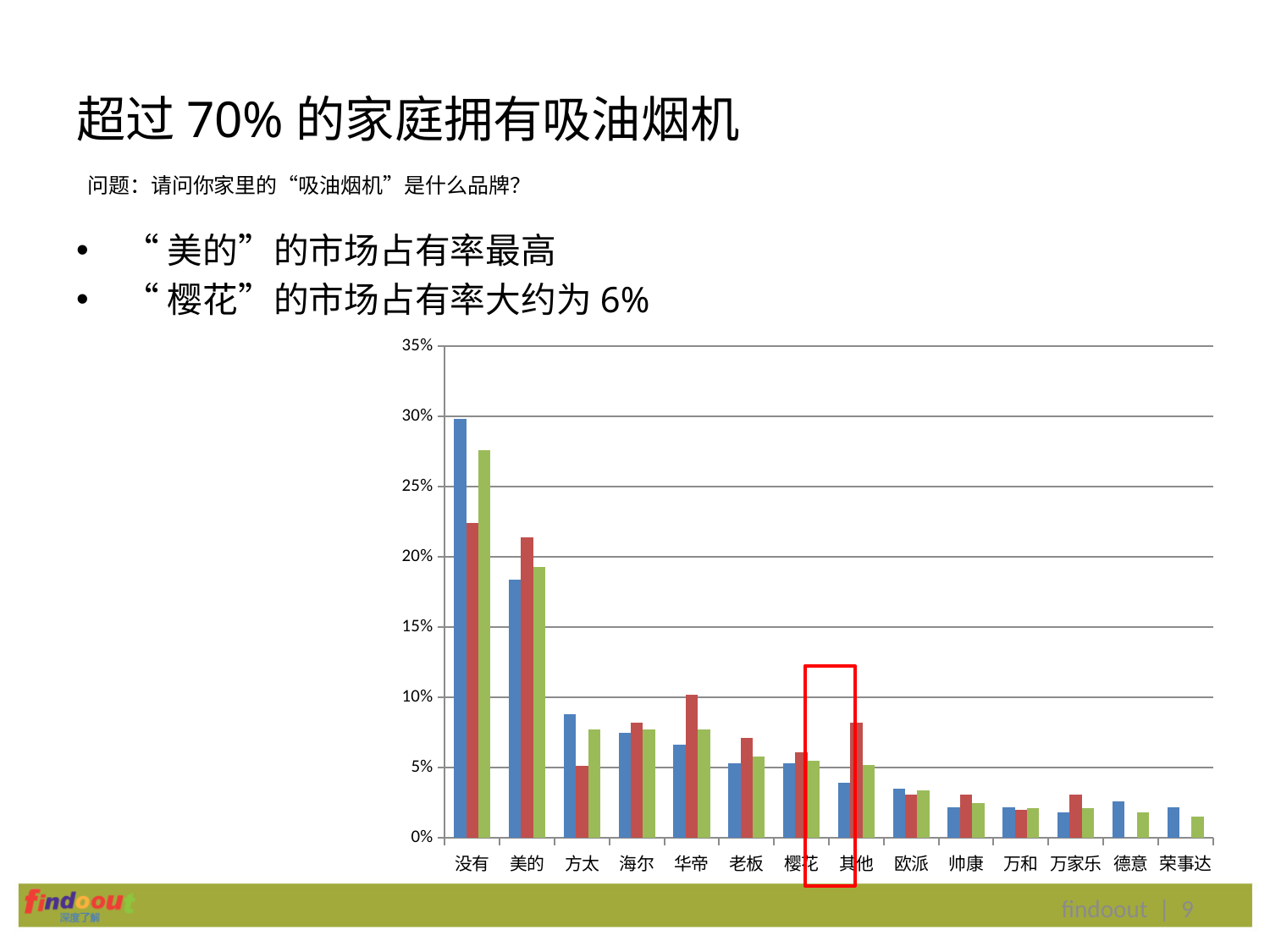
Is the blue bar for 荣事达 greater or less than 5%? less Among the brand categories (excluding 没有), which has the tallest red bar? 美的 Do the blue bars generally rise or fall from left to right across the chart? fall Is the blue bar for 没有 greater or less than 25%? greater Which category has the tallest blue bar in the chart? 没有 How many categories are shown along the x axis of the chart? 14 Which category on the x axis is highlighted with a red box? 其他 Which is larger: the red bar for 华帝 or the red bar for 老板? 华帝 Is the red bar for 美的 greater or less than 20%? greater What kind of chart is shown on the slide? bar chart Which is larger: the green bar for 方太 or the green bar for 欧派? 方太